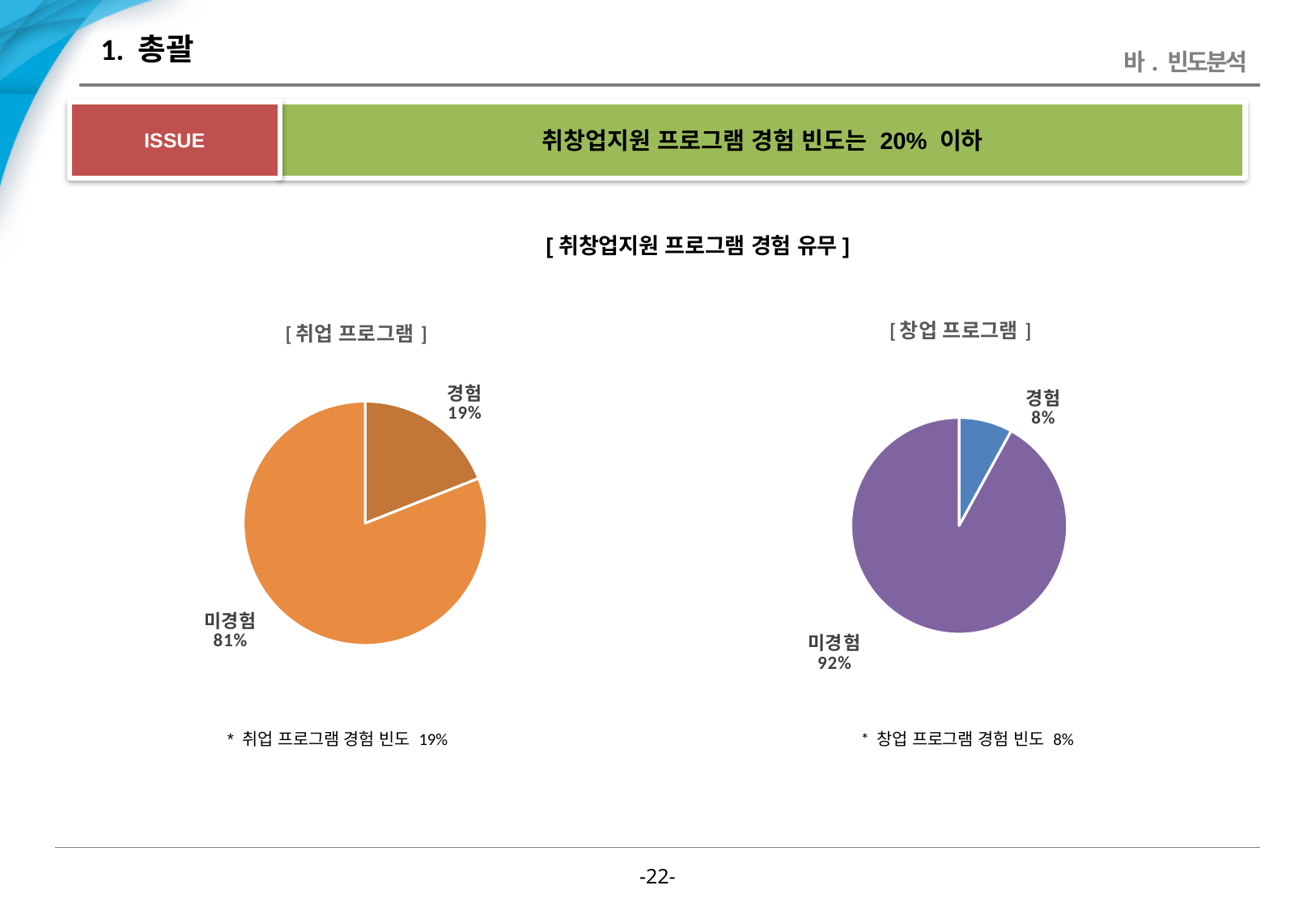
Which is larger: 경험 in the [취업 프로그램] chart or 경험 in the [창업 프로그램] chart? 경험 in the [취업 프로그램] chart In the [취업 프로그램] pie chart, what is the difference between 미경험 and 경험? 62% In the [취업 프로그램] pie chart, what is the value for 경험? 19% In the [창업 프로그램] pie chart, what is the value for 미경험? 92% In the [취업 프로그램] pie chart, what is the value for 미경험? 81% In the [창업 프로그램] pie chart, what is the difference between 미경험 and 경험? 84% How many slices does the [창업 프로그램] pie chart have? 2 What is the overall title shown above the two pie charts? [ 취창업지원 프로그램 경험 유무 ] What kind of chart is the [취업 프로그램] chart? Pie chart In the [창업 프로그램] pie chart, what is the value for 경험? 8% In the [취업 프로그램] pie chart, which slice is the largest? 미경험 In the [창업 프로그램] pie chart, which slice is the smallest? 경험